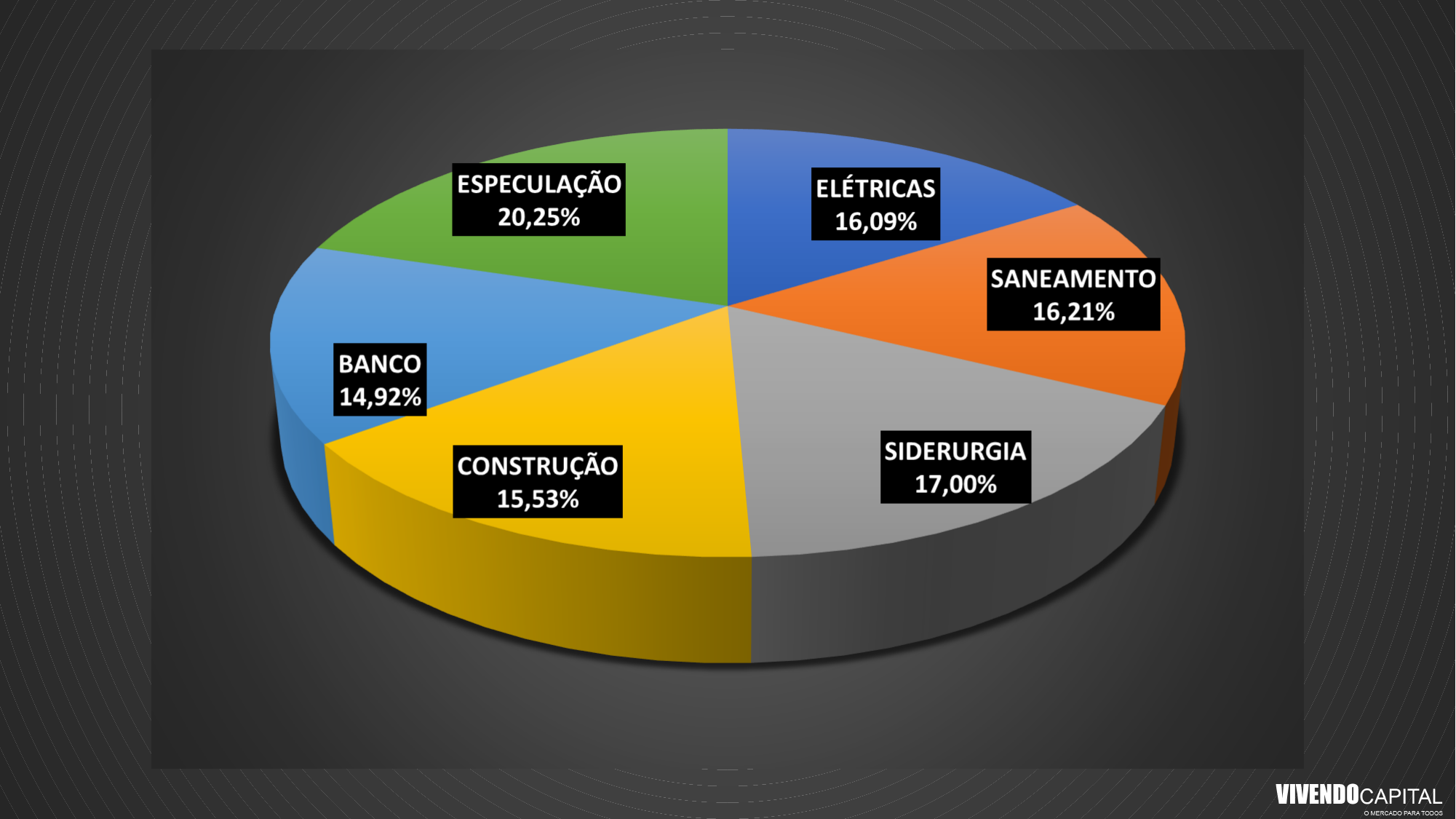
Which category has the smallest share of the pie? BANCO What colour is the ESPECULAÇÃO slice? Green Which is larger, SANEAMENTO or ELÉTRICAS? SANEAMENTO What is the difference in percentage points between ESPECULAÇÃO and BANCO? 5,33 percentage points How many slices does the pie chart have? 6 What is the difference in percentage points between SIDERURGIA and CONSTRUÇÃO? 1,47 percentage points What percentage does the ESPECULAÇÃO slice represent? 20,25% What kind of chart is shown on the slide? Pie chart What is the value for SANEAMENTO? 16,21% What is the value shown for SIDERURGIA? 17,00% What percentage is labelled for BANCO? 14,92% Which category has the largest share of the pie? ESPECULAÇÃO